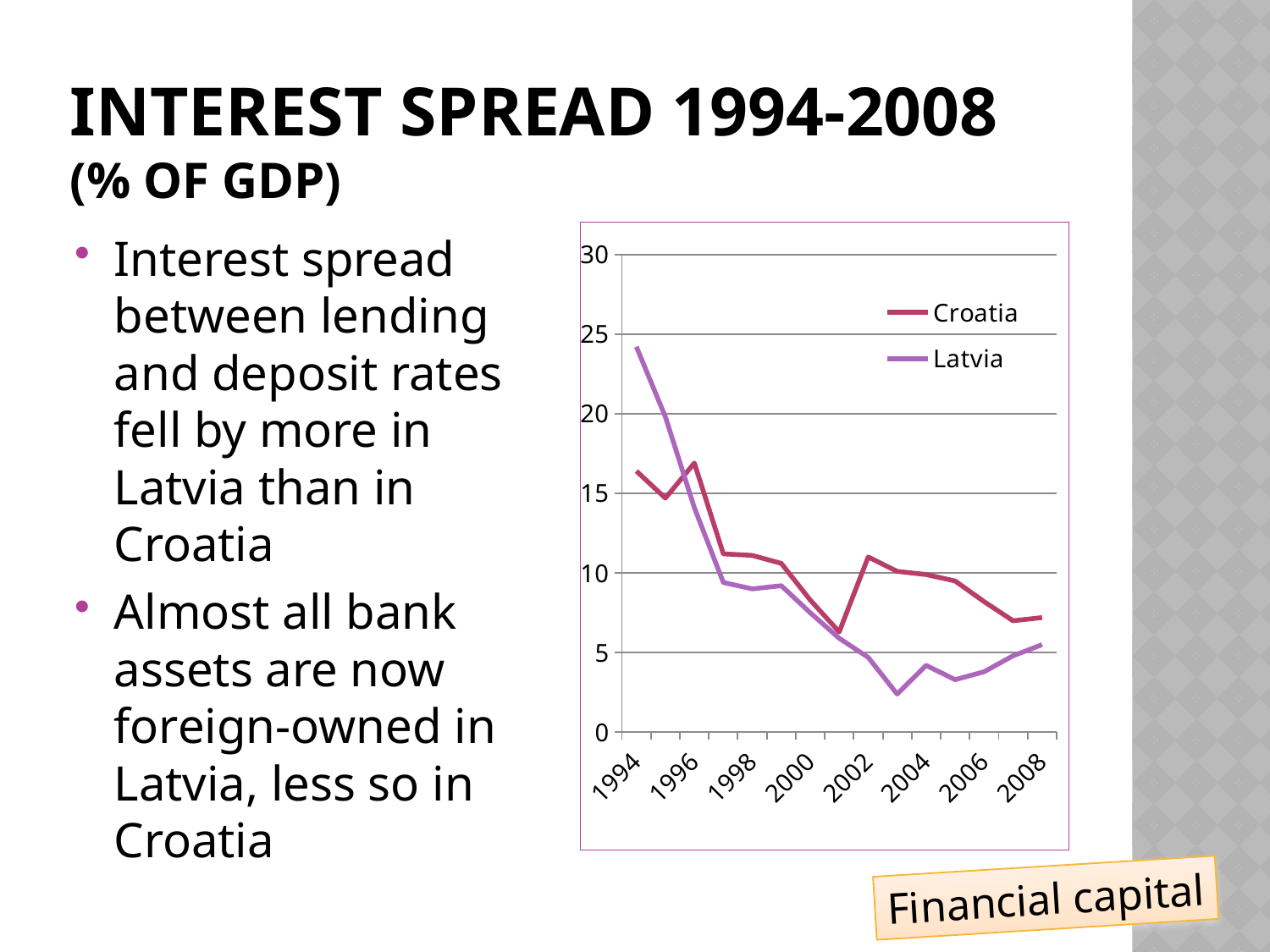
Is the value for Latvia in 1994 greater or less than 20? greater Is the value for Croatia in 2008 greater or less than 5? greater Is the value for Croatia in 2006 greater or less than 10? less How many series does the chart legend list? 2 What kind of chart is shown on the slide? line chart In which year does the Latvia line reach its highest value? 1994 How many year labels are shown on the x axis of the chart? 8 Which two countries are shown in the chart legend? Croatia and Latvia Overall, does the Latvia line rise or fall from 1994 to 2008? fall In 1994, which country has the higher interest spread, Croatia or Latvia? Latvia In 2004, which country has the higher interest spread, Croatia or Latvia? Croatia Overall, does the Croatia line rise or fall from 1994 to 2008? fall